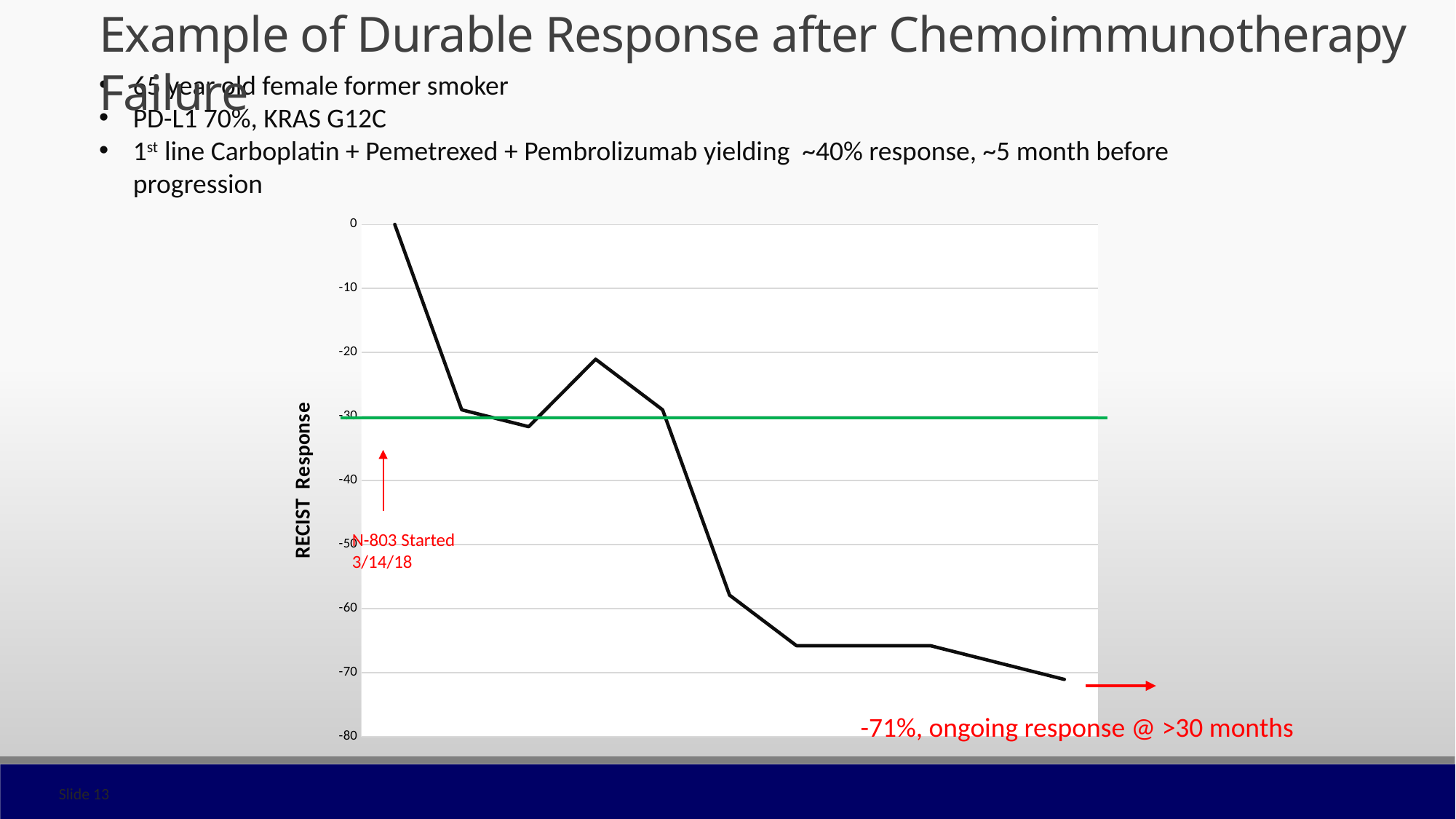
Is the value of the sixth data point (just after the steep drop) greater or less than -50? less At what y-axis value is the horizontal green reference line drawn? -30 What is the value of the final data point on the line, as annotated on the slide? -71% Do the values on the line generally rise or fall from left to right? fall What is the label on the vertical axis of the chart? RECIST Response What kind of chart is shown on the slide? line chart Is the value of the last data point greater or less than -60? less Which data point has the lowest value on the line? the last point Is the value of the fourth data point (the local peak in the middle of the line) greater or less than -30? greater Which data point has the highest value on the line? the first point What is the value of the first data point on the line? 0